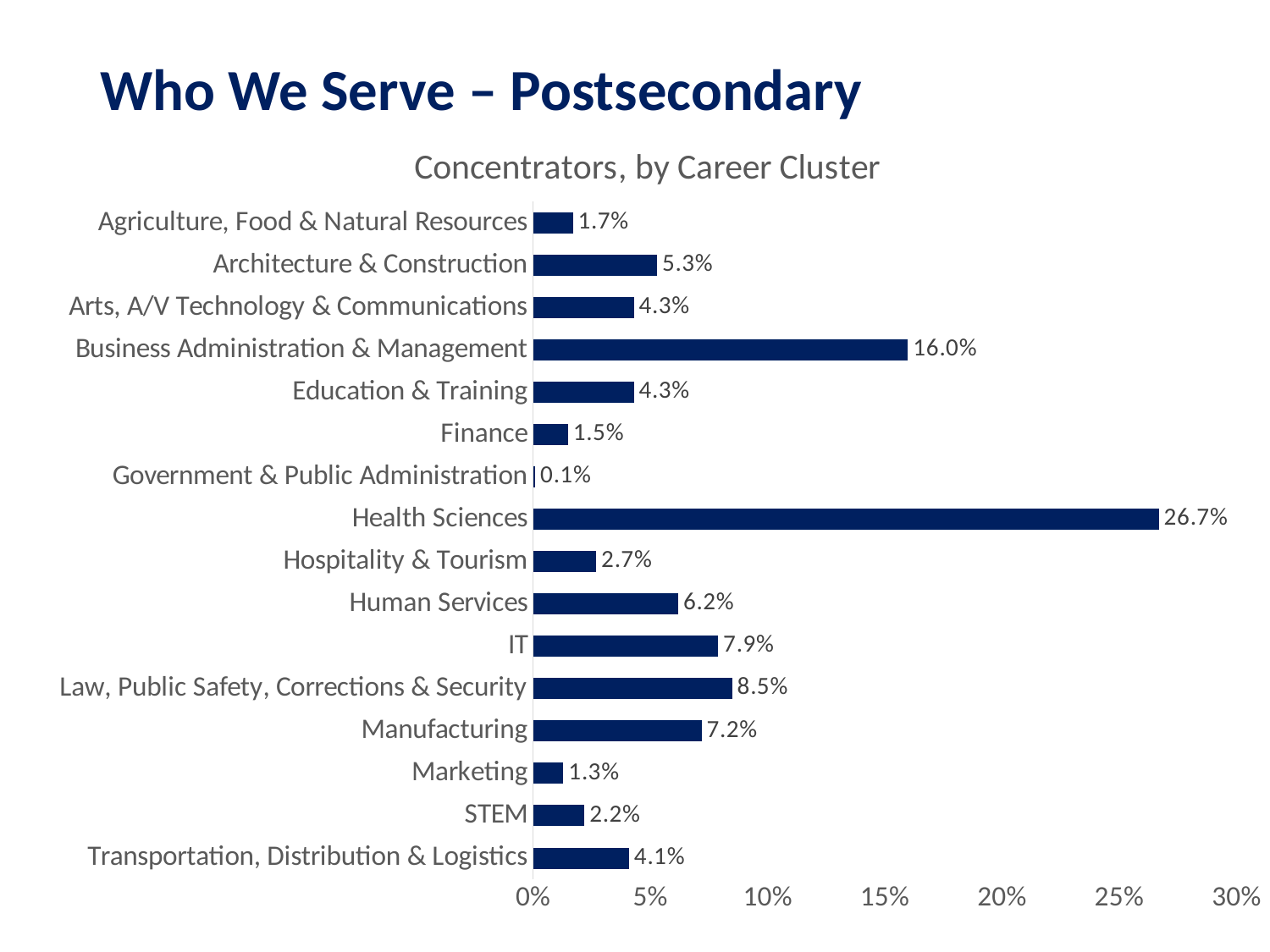
What is the value for Law, Public Safety, Corrections & Security? 8.5% Which career cluster has the lowest share of concentrators? Government & Public Administration What is the value for Business Administration & Management? 16.0% Which career cluster has the highest share of concentrators? Health Sciences How many career clusters are shown in the chart? 16 What is the difference between the values for Health Sciences and Business Administration & Management? 10.7% Is the value for Human Services greater or less than 5%? greater What is the value for Marketing? 1.3% What kind of chart is shown on the slide? Bar chart What is the title of the chart? Concentrators, by Career Cluster Which is larger, the value for IT or the value for Manufacturing? IT What is the value for Health Sciences? 26.7%